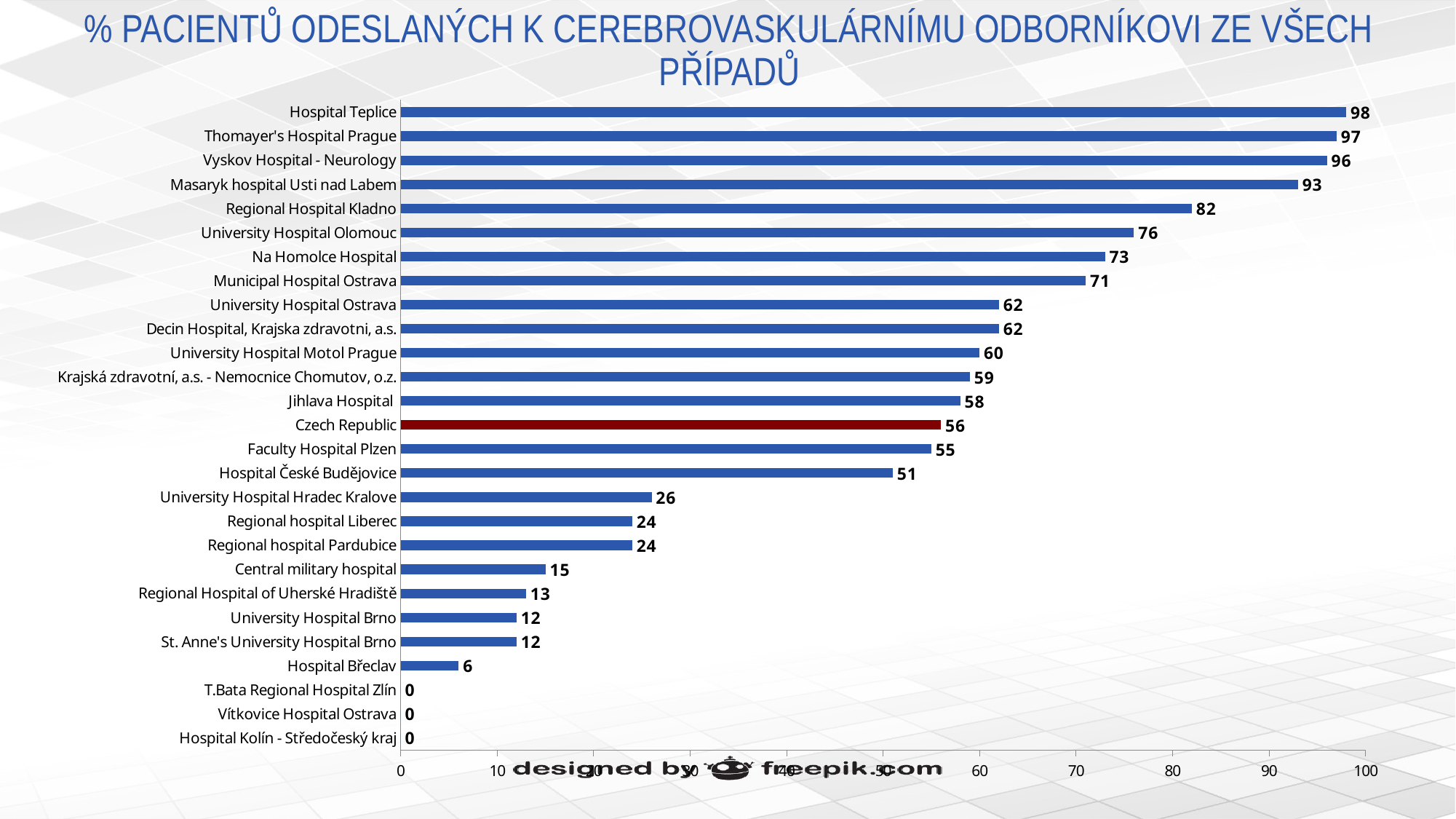
What kind of chart is shown on the slide? bar chart Is the value for Masaryk hospital Usti nad Labem greater or less than 90? greater Which category has the highest value? Hospital Teplice What is the value for University Hospital Hradec Kralove? 26 What is the difference between the values for Regional Hospital Kladno and University Hospital Olomouc? 6 What is the value for Hospital Teplice? 98 How many categories are shown in the chart? 27 Which is larger, the value for Na Homolce Hospital or the value for Municipal Hospital Ostrava? Na Homolce Hospital What is the difference between the values for Hospital Teplice and Czech Republic? 42 What is the value for Hospital Břeclav? 6 What is the value for Czech Republic? 56 Which category's bar is coloured dark red instead of blue? Czech Republic